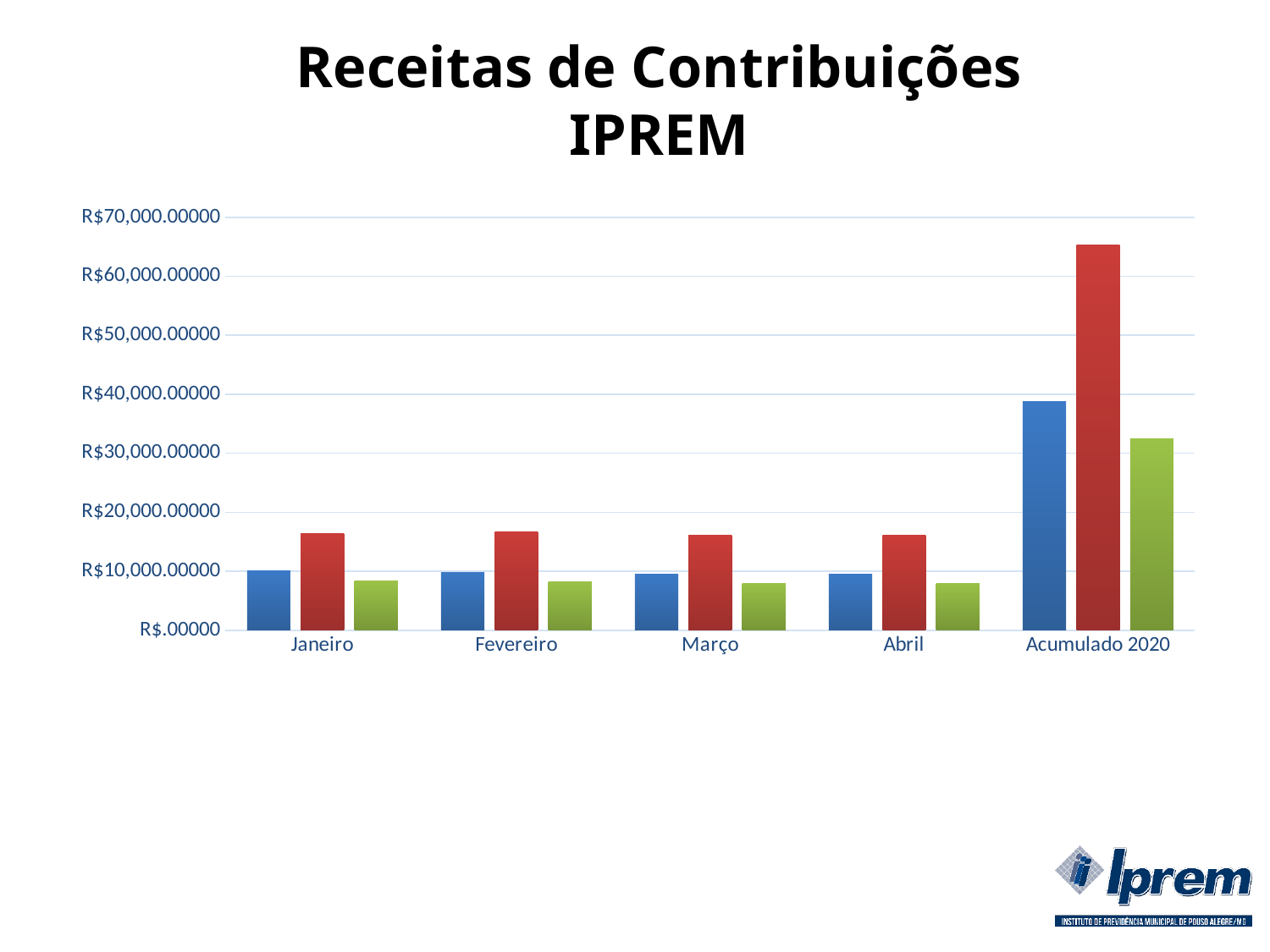
How many bars are shown for each category in the chart? 3 Is the value of the green bar for Fevereiro greater or less than R$10,000.00000? less Which category has the tallest bar in the chart? Acumulado 2020 Is the value of the blue bar for Acumulado 2020 greater or less than R$40,000.00000? less What is the title of the chart on the slide? Receitas de Contribuições IPREM Is the value of the green bar for Acumulado 2020 greater or less than R$30,000.00000? greater How many categories are shown on the x axis of the chart? 5 For Março, which is larger: the red bar or the green bar? the red bar What kind of chart is shown on the slide? bar chart For Acumulado 2020, which is larger: the red bar or the blue bar? the red bar